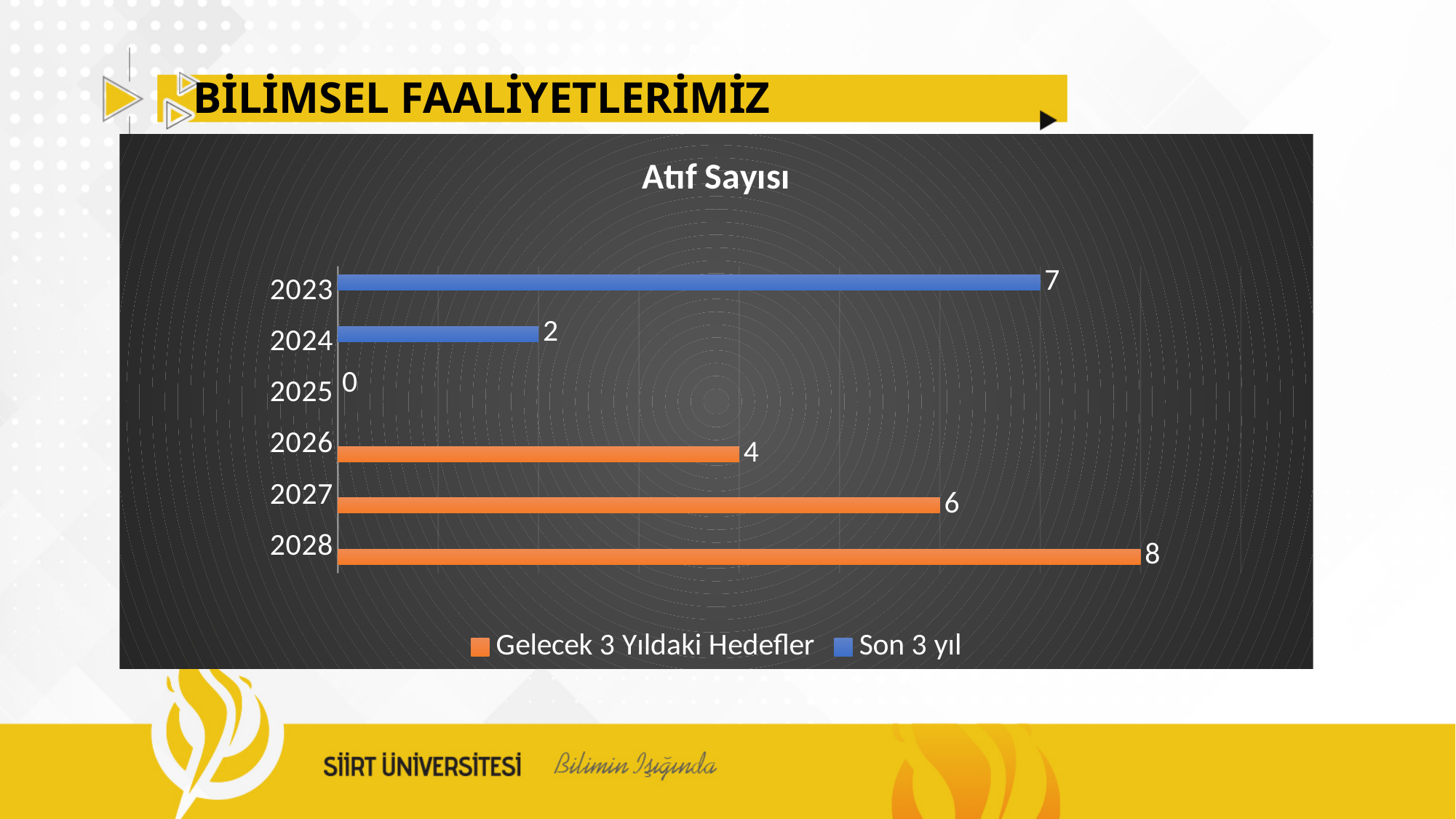
How many series does the legend list? 2 What is the value for 2024 in the Atıf Sayısı chart? 2 How many years are shown on the axis of the Atıf Sayısı chart? 6 What is the value for 2027 in the Atıf Sayısı chart? 6 What is the title of the chart? Atıf Sayısı Which is larger, the value for 2023 or the value for 2027? 2023 What is the difference between the values for 2028 and 2026? 4 Which year has the highest value in the Atıf Sayısı chart? 2028 What kind of chart is shown on the slide? Bar chart What is the value for 2023 in the Atıf Sayısı chart? 7 Which year has the lowest value in the Atıf Sayısı chart? 2025 What is the value for 2025 in the Atıf Sayısı chart? 0